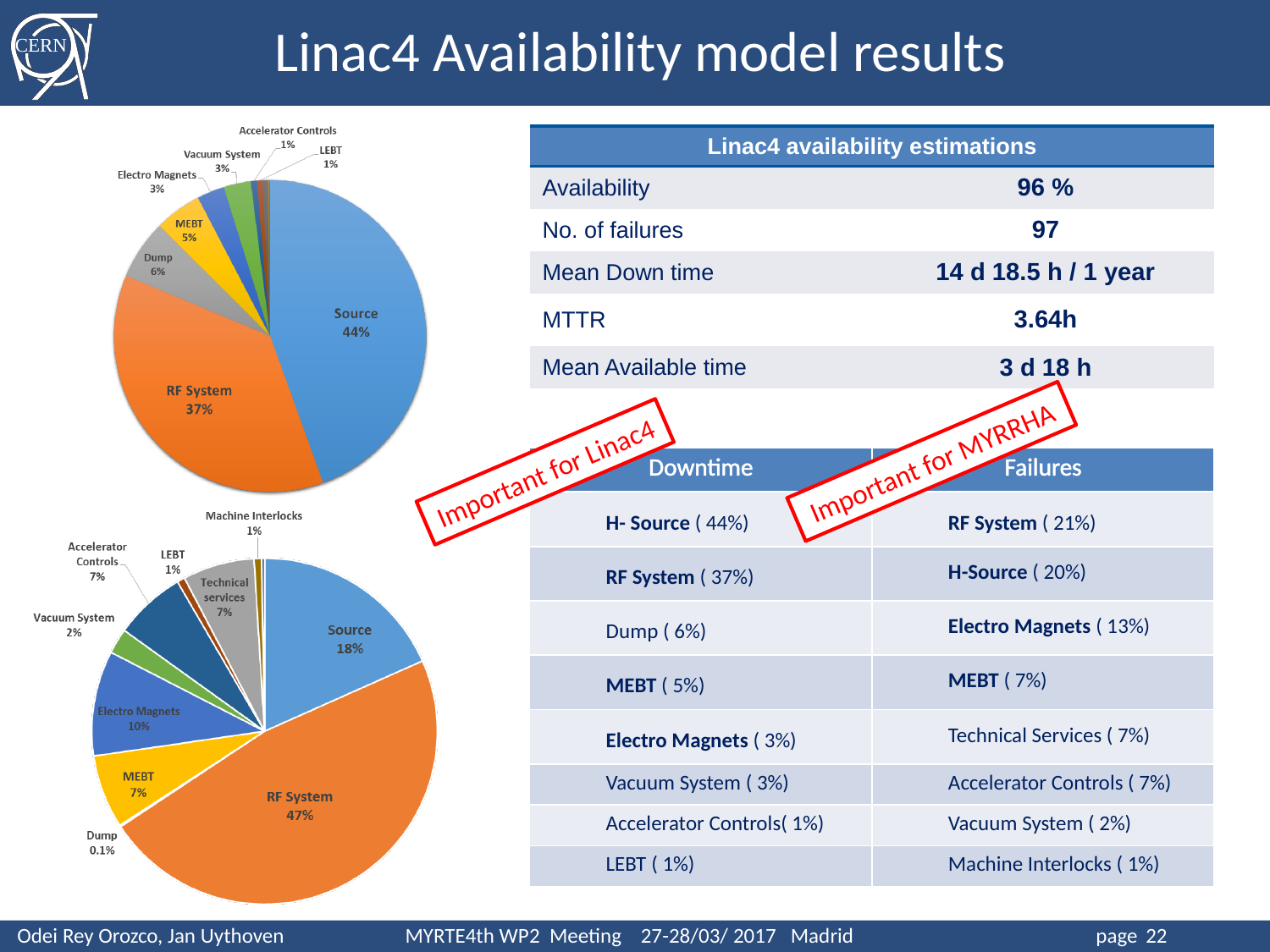
On the bottom pie chart, which category has the smallest share? Dump On the top pie chart, which category has the largest share? Source On the top pie chart, what share does the RF System slice have? 37% On the bottom pie chart, what is the difference between the RF System and Source shares? 29% On the bottom pie chart, what share does the RF System slice have? 47% How many categories are shown on the bottom pie chart? 10 On the top pie chart, what is the difference between the Source and RF System shares? 7% On the top pie chart, what share does the Source slice have? 44% What type of chart is the top chart on the slide? Pie chart On the top pie chart, which is larger, Dump or MEBT? Dump On the bottom pie chart, what share does the Dump slice have? 0.1% How many categories are shown on the top pie chart? 8